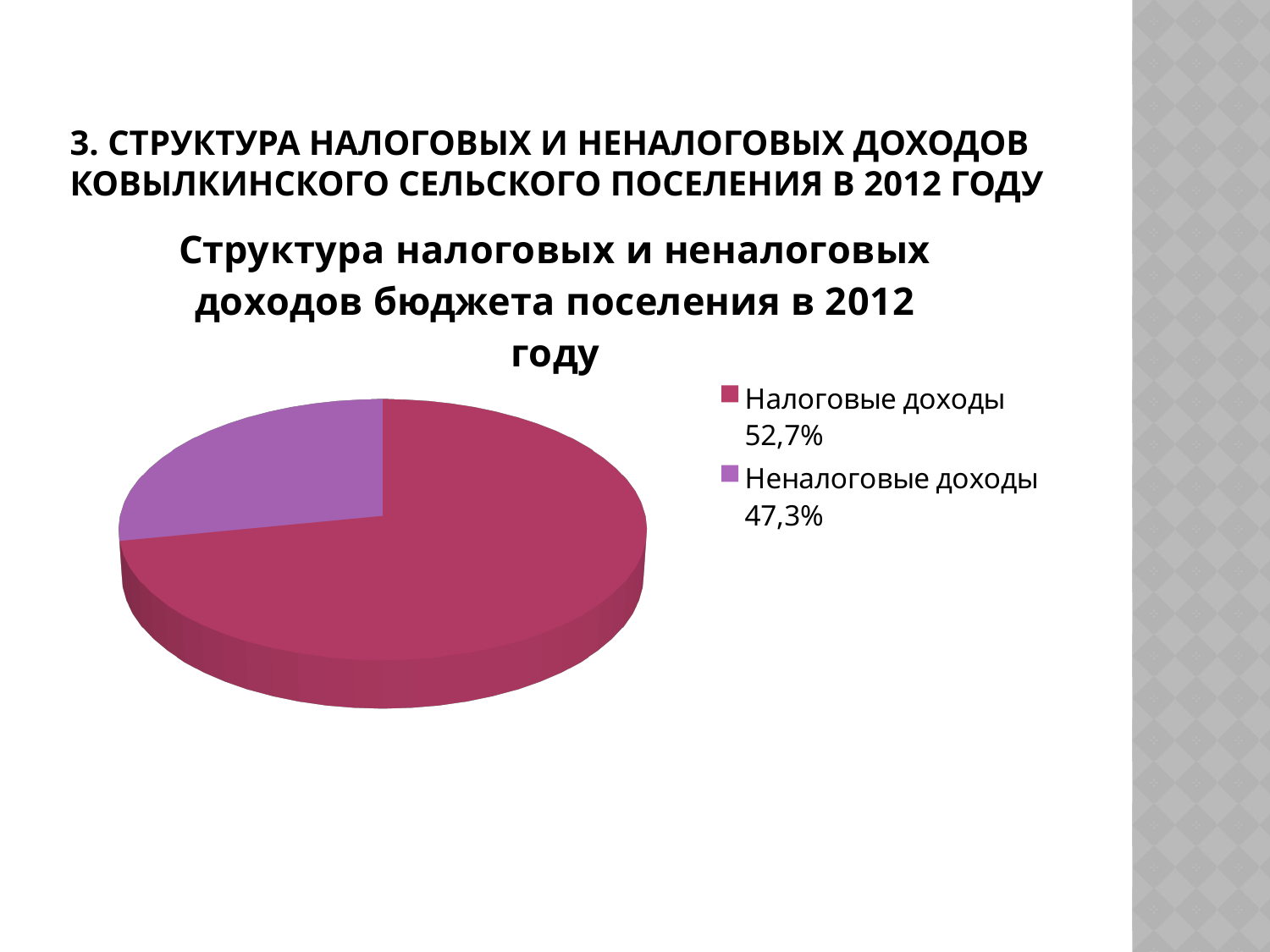
What is the difference in percentage points between Налоговые доходы (52,7%) and Неналоговые доходы (47,3%)? 5,4% How many entries does the legend of the pie chart list? 2 What kind of chart is shown on the slide? pie chart What percentage is shown for Неналоговые доходы in the legend? 47,3% How many slices does the pie chart have? 2 What colour is the slice for Неналоговые доходы? purple Which category has the smallest share of the pie? Неналоговые доходы Which is larger, the share of Налоговые доходы or the share of Неналоговые доходы? Налоговые доходы What share of the pie does Неналоговые доходы represent according to the legend? 47,3% What is the title of the pie chart? Структура налоговых и неналоговых доходов бюджета поселения в 2012 году What percentage is shown for Налоговые доходы in the legend? 52,7% Which category has the largest share of the pie? Налоговые доходы